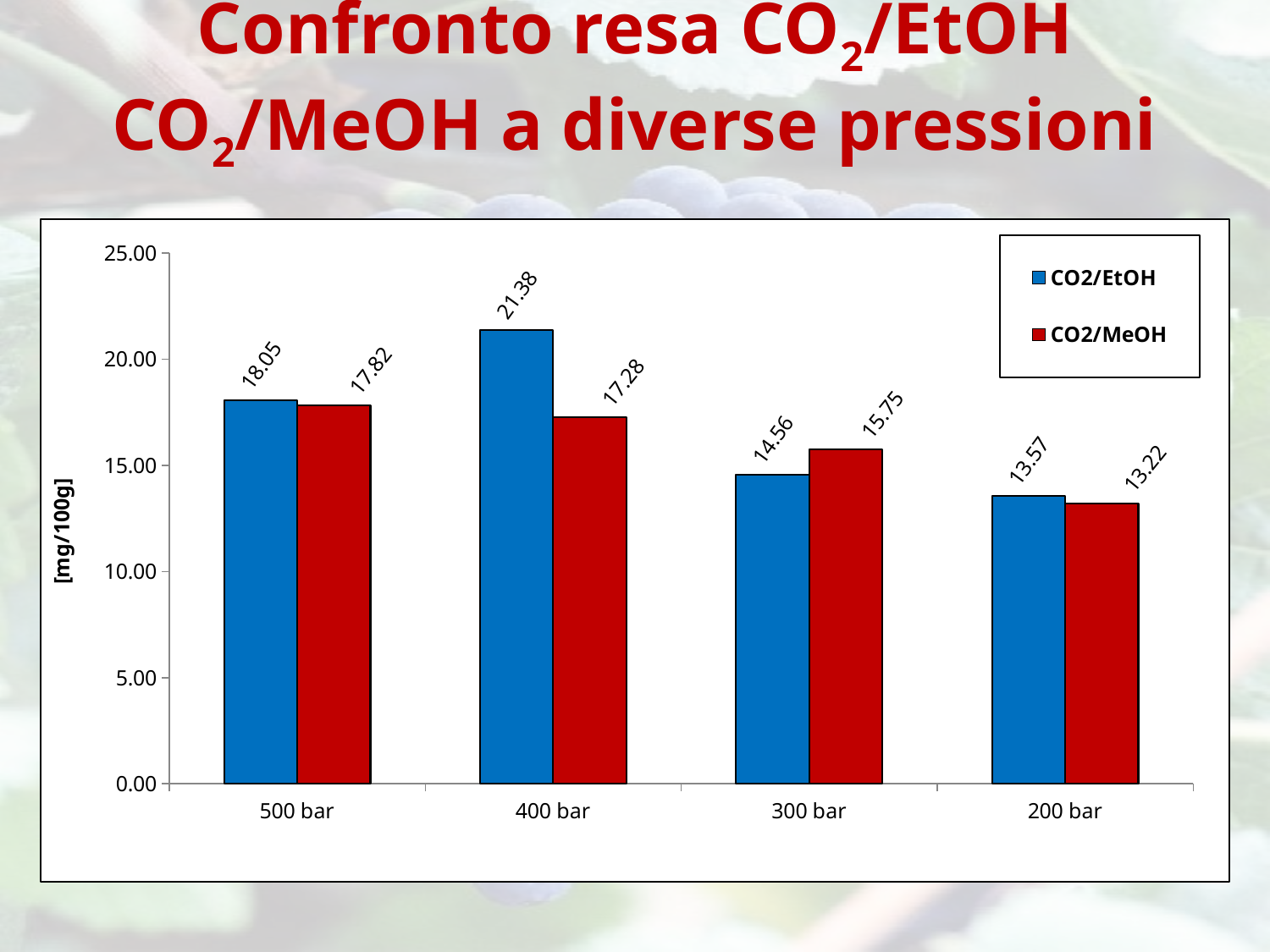
What is the CO2/EtOH value at 400 bar? 21.38 What kind of chart is shown on the slide? bar chart At 300 bar, which series has the larger value, CO2/EtOH or CO2/MeOH? CO2/MeOH What is the CO2/MeOH value at 300 bar? 15.75 How many pressure categories are shown on the x axis? 4 Is the CO2/MeOH value at 500 bar greater or less than 15.00? greater What unit is shown on the y axis label? [mg/100g] How many series does the legend list? 2 What is the difference between the CO2/EtOH and CO2/MeOH values at 400 bar? 4.10 At which pressure is the CO2/EtOH value highest? 400 bar What is the CO2/EtOH value at 200 bar? 13.57 At which pressure is the CO2/MeOH value lowest? 200 bar